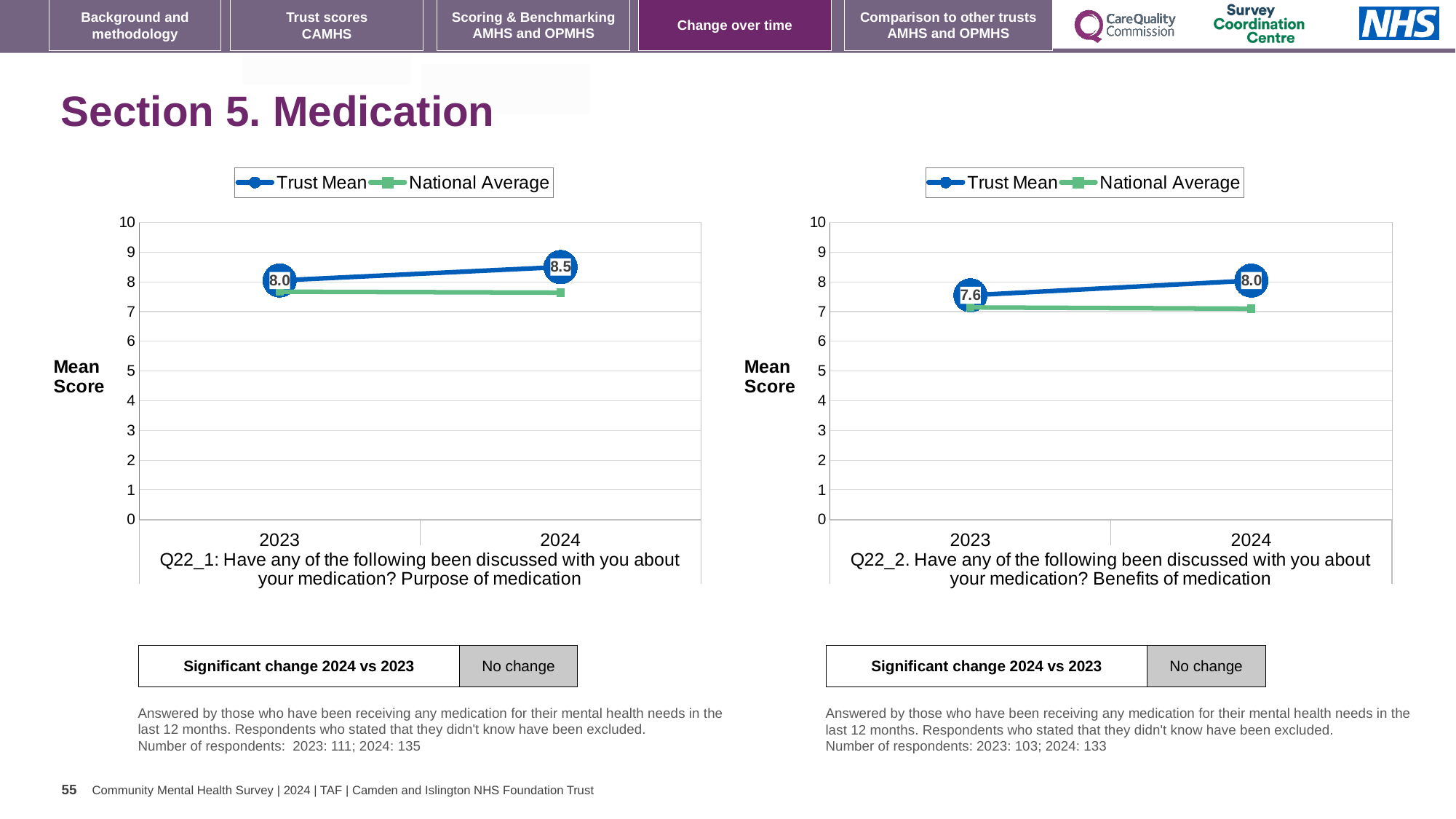
How many years are shown on the x axis of the Q22_1 Purpose of medication chart? 2 How many series does the legend of the Q22_2 Benefits of medication chart list? 2 In the Q22_1 Purpose of medication chart, by how much did the Trust Mean change from 2023 to 2024? 0.5 In the Q22_1 Purpose of medication chart, which is larger in 2024, the Trust Mean or the National Average? Trust Mean In the Q22_1 Purpose of medication chart, what is the Trust Mean for 2023? 8.0 In the Q22_2 Benefits of medication chart, what is the Trust Mean for 2023? 7.6 In the Q22_2 Benefits of medication chart, does the Trust Mean rise or fall from 2023 to 2024? rise In the Q22_2 Benefits of medication chart, what is the difference between the Trust Mean in 2024 and in 2023? 0.4 In the Q22_1 Purpose of medication chart, what is the Trust Mean for 2024? 8.5 In the Q22_2 Benefits of medication chart, is the National Average for 2024 greater or less than 8? less What kind of chart is the Q22_1 Purpose of medication chart? line chart In the Q22_2 Benefits of medication chart, what is the Trust Mean for 2024? 8.0